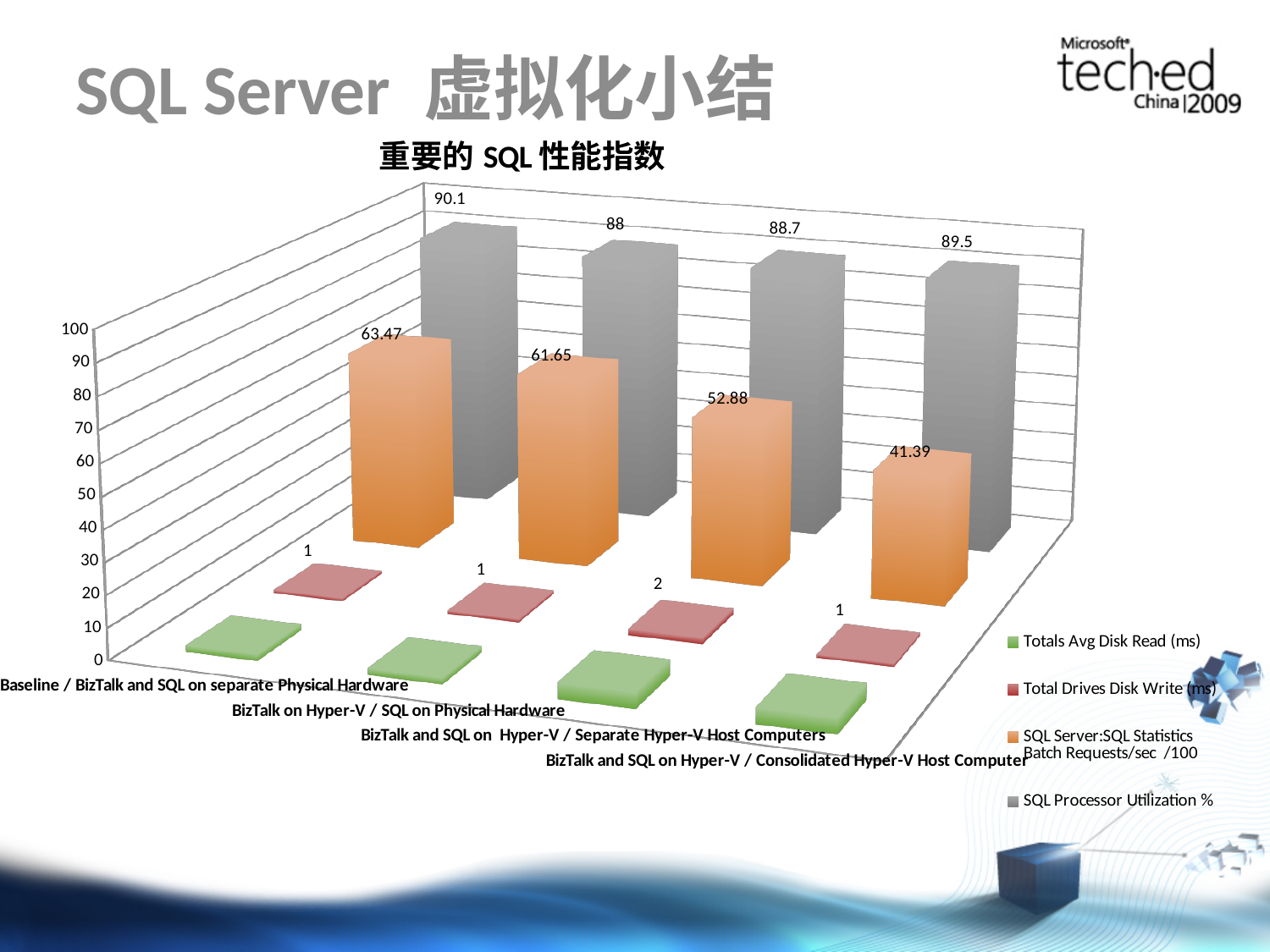
Do the SQL Server:SQL Statistics Batch Requests/sec /100 values rise or fall from the Baseline category to the Consolidated Hyper-V Host Computer category? fall How many categories are shown on the x axis of the chart? 4 What kind of chart is shown on the slide? bar chart How many series does the legend list? 4 Which category has the highest SQL Server:SQL Statistics Batch Requests/sec /100 value? Baseline / BizTalk and SQL on separate Physical Hardware What is the SQL Processor Utilization % value for the Baseline / BizTalk and SQL on separate Physical Hardware category? 90.1 What is the SQL Server:SQL Statistics Batch Requests/sec /100 value for BizTalk and SQL on Hyper-V / Consolidated Hyper-V Host Computer? 41.39 What is the difference in SQL Processor Utilization % between the Baseline category and BizTalk on Hyper-V / SQL on Physical Hardware? 2.1 Which has the larger Batch Requests/sec /100 value: BizTalk and SQL on Hyper-V / Separate Hyper-V Host Computers or BizTalk and SQL on Hyper-V / Consolidated Hyper-V Host Computer? BizTalk and SQL on Hyper-V / Separate Hyper-V Host Computers Which category has the lowest SQL Processor Utilization % value? BizTalk on Hyper-V / SQL on Physical Hardware What is the Total Drives Disk Write (ms) value for BizTalk and SQL on Hyper-V / Separate Hyper-V Host Computers? 2 What is the difference in Batch Requests/sec /100 between the Baseline category and the Consolidated Hyper-V Host Computer category? 22.08